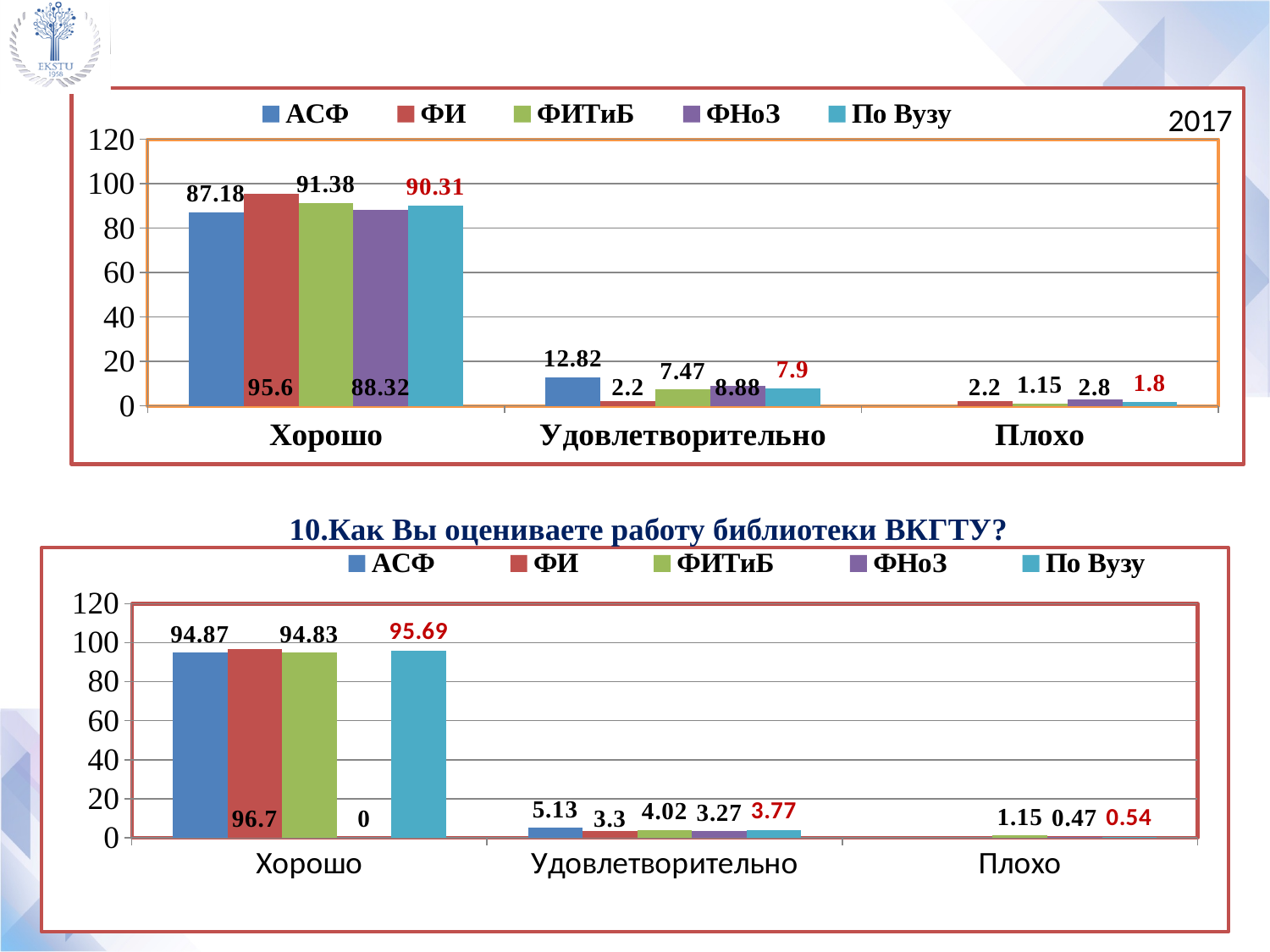
In the top chart (2017), what is the difference between the ФИ and АСФ values in the Хорошо category? 8.42 In the top chart (2017), what is the value for АСФ in the Удовлетворительно category? 12.82 What type of chart is the bottom chart (10.Как Вы оцениваете работу библиотеки ВКГТУ?)? bar chart In the top chart (2017), what is the value for ФИ in the Хорошо category? 95.6 In the top chart (2017), what is the value for ФНоЗ in the Плохо category? 2.8 In the bottom chart (10.Как Вы оцениваете работу библиотеки ВКГТУ?), what is the value for По Вузу in the Хорошо category? 95.69 In the bottom chart (10.Как Вы оцениваете работу библиотеки ВКГТУ?), what is the value for ФНоЗ in the Хорошо category? 0 In the top chart (2017), which series has the highest value in the Хорошо category? ФИ In the top chart (2017), how many series does the legend list? 5 In the bottom chart (10.Как Вы оцениваете работу библиотеки ВКГТУ?), how many categories are shown on the x axis? 3 In the bottom chart (10.Как Вы оцениваете работу библиотеки ВКГТУ?), is the value for АСФ in the Удовлетворительно category larger or smaller than the value for ФИ in the same category? larger In the bottom chart (10.Как Вы оцениваете работу библиотеки ВКГТУ?), which series has the highest value in the Удовлетворительно category? АСФ